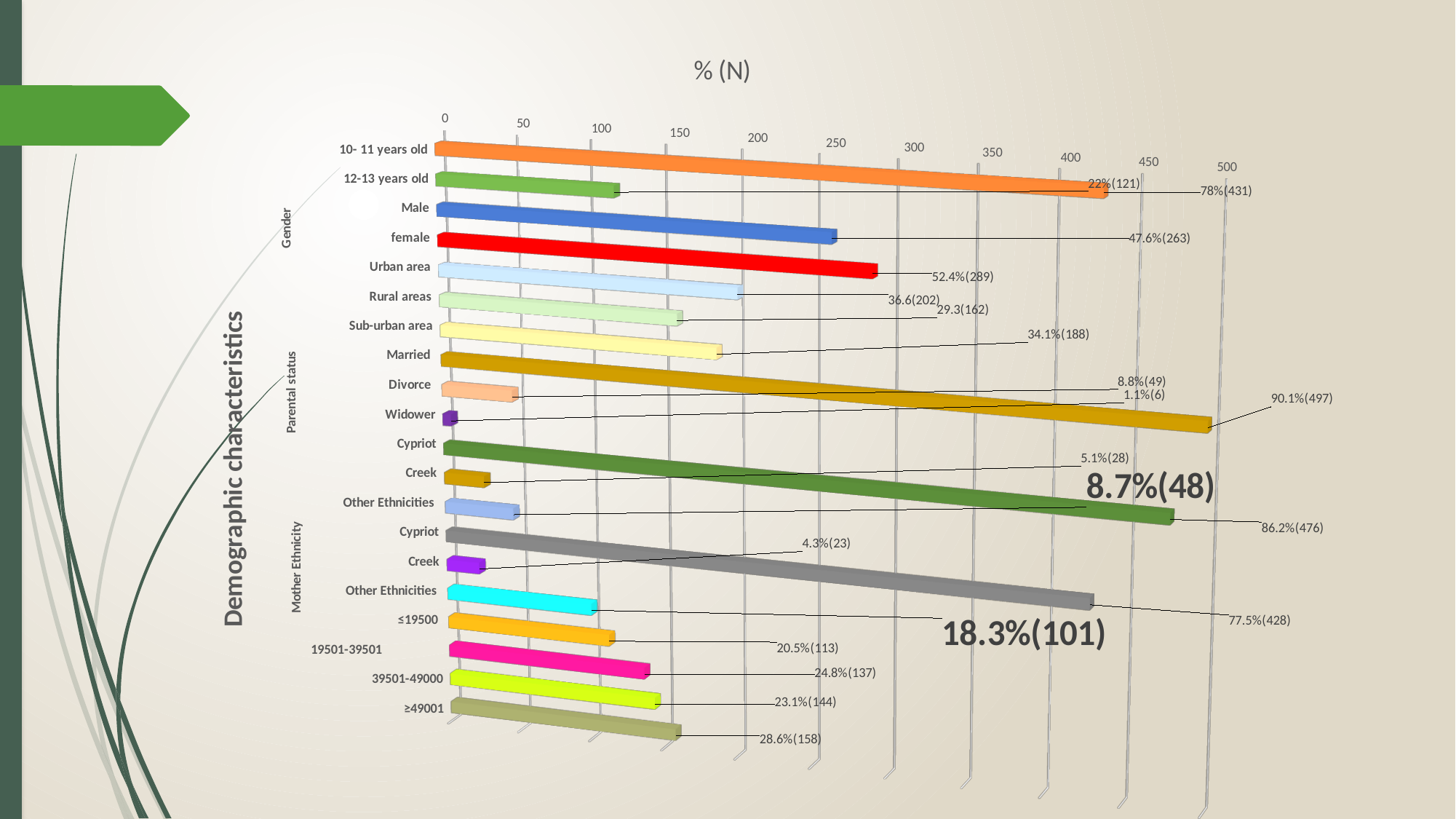
Which category has the longest bar? Married What value is labelled for the Married bar? 90.1%(497) What value is labelled for the Widower bar? 1.1%(6) What kind of chart is shown on the slide? Bar chart Which bar is longer, Urban area or Rural areas? Urban area Is the value for 12-13 years old greater or less than 150? less What value is labelled for the 10-11 years old bar? 78%(431) What value is labelled for the ≥49001 bar? 28.6%(158) What value is labelled for the female bar? 52.4%(289) Which category has the shortest bar? Widower What is the difference in N between female (289) and Male (263)? 26 How many category bars are plotted on the chart? 20